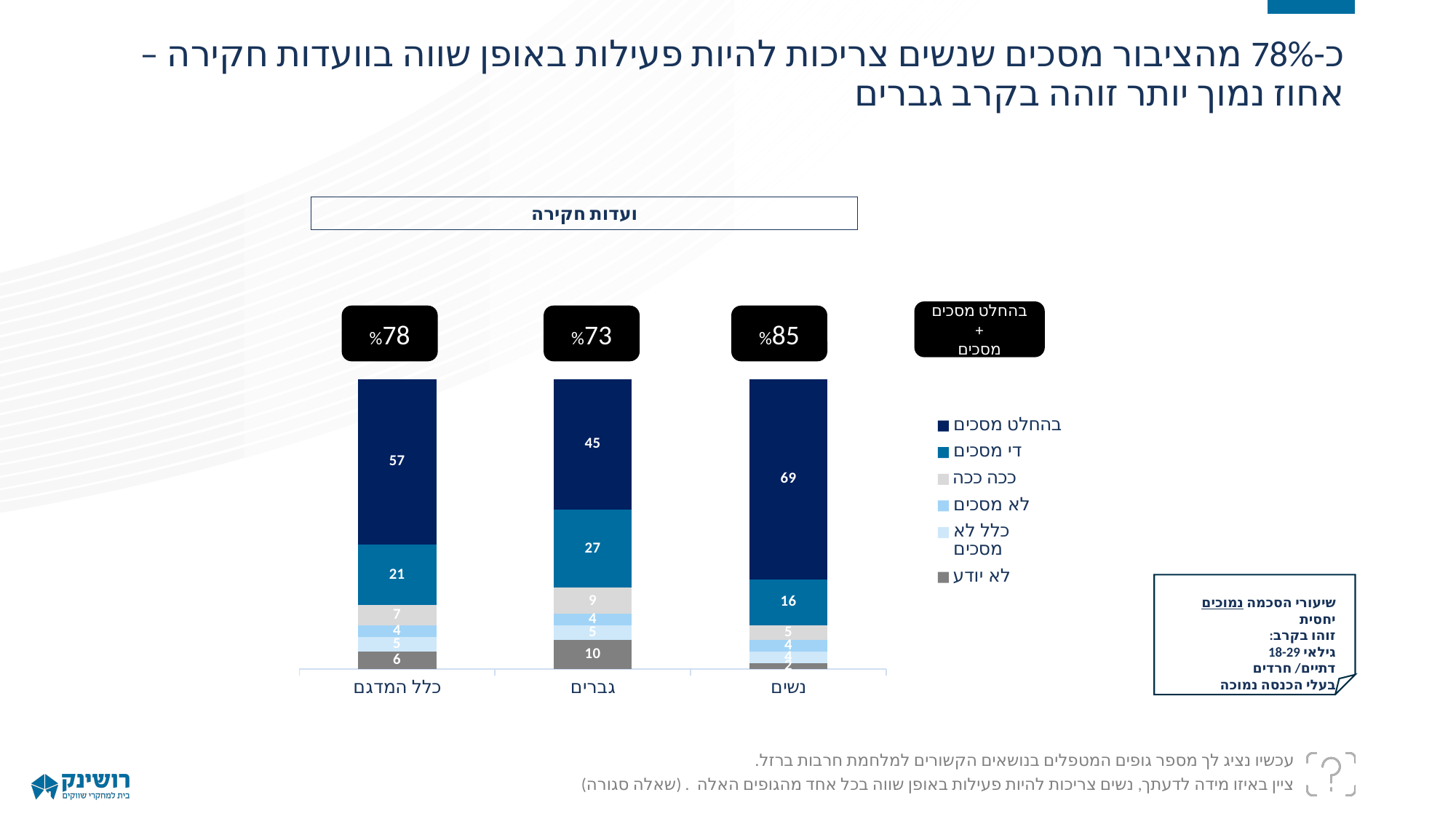
What combined percentage (בהחלט מסכים + מסכים) is shown above the bar for גברים? 73% What is the difference between the בהחלט מסכים values for נשים and גברים? 24 How many series does the legend list? 6 How many categories are shown on the x axis? 3 What is the value of בהחלט מסכים for נשים? 69 What is the value of לא יודע for כלל המדגם? 6 What is the title shown above the chart? ועדות חקירה What kind of chart is shown on the slide? stacked bar chart Which is larger: די מסכים for גברים or די מסכים for נשים? גברים What is the value of די מסכים for גברים? 27 Which category has the highest value for בהחלט מסכים? נשים Which category has the lowest value for לא יודע? נשים